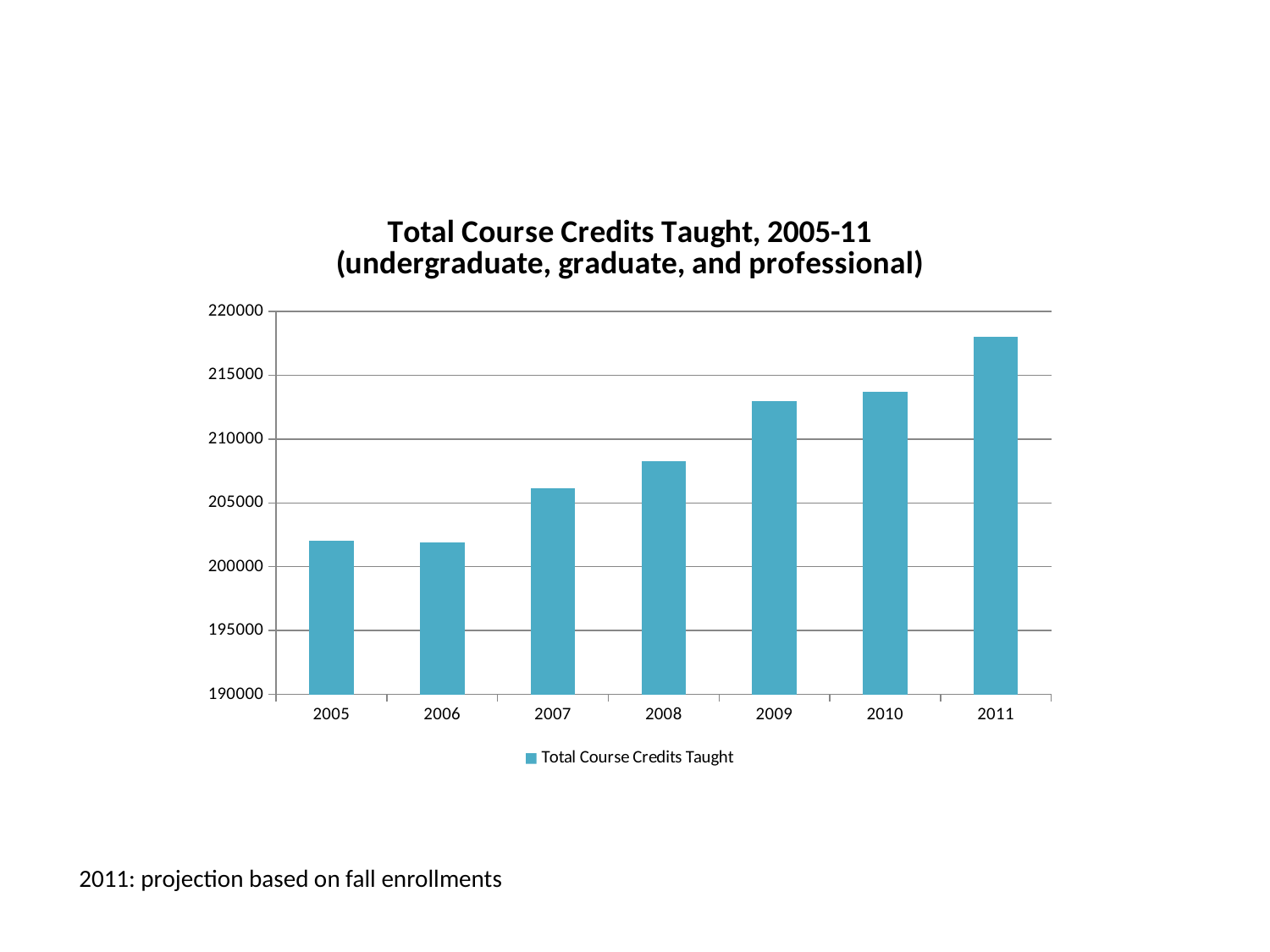
What series name is shown in the legend? Total Course Credits Taught Is the value for 2011 greater or less than 215000? greater How many series does the legend list? 1 Which is larger, the value for 2007 or the value for 2009? 2009 Do the values generally rise or fall from 2005 to 2011? rise Is the value for 2008 greater or less than 210000? less How many years are shown on the x axis of the chart? 7 Is the value for 2009 greater or less than 210000? greater Which year has the highest total course credits taught? 2011 What kind of chart is shown on the slide? bar chart What is the title of the chart? Total Course Credits Taught, 2005-11 (undergraduate, graduate, and professional)